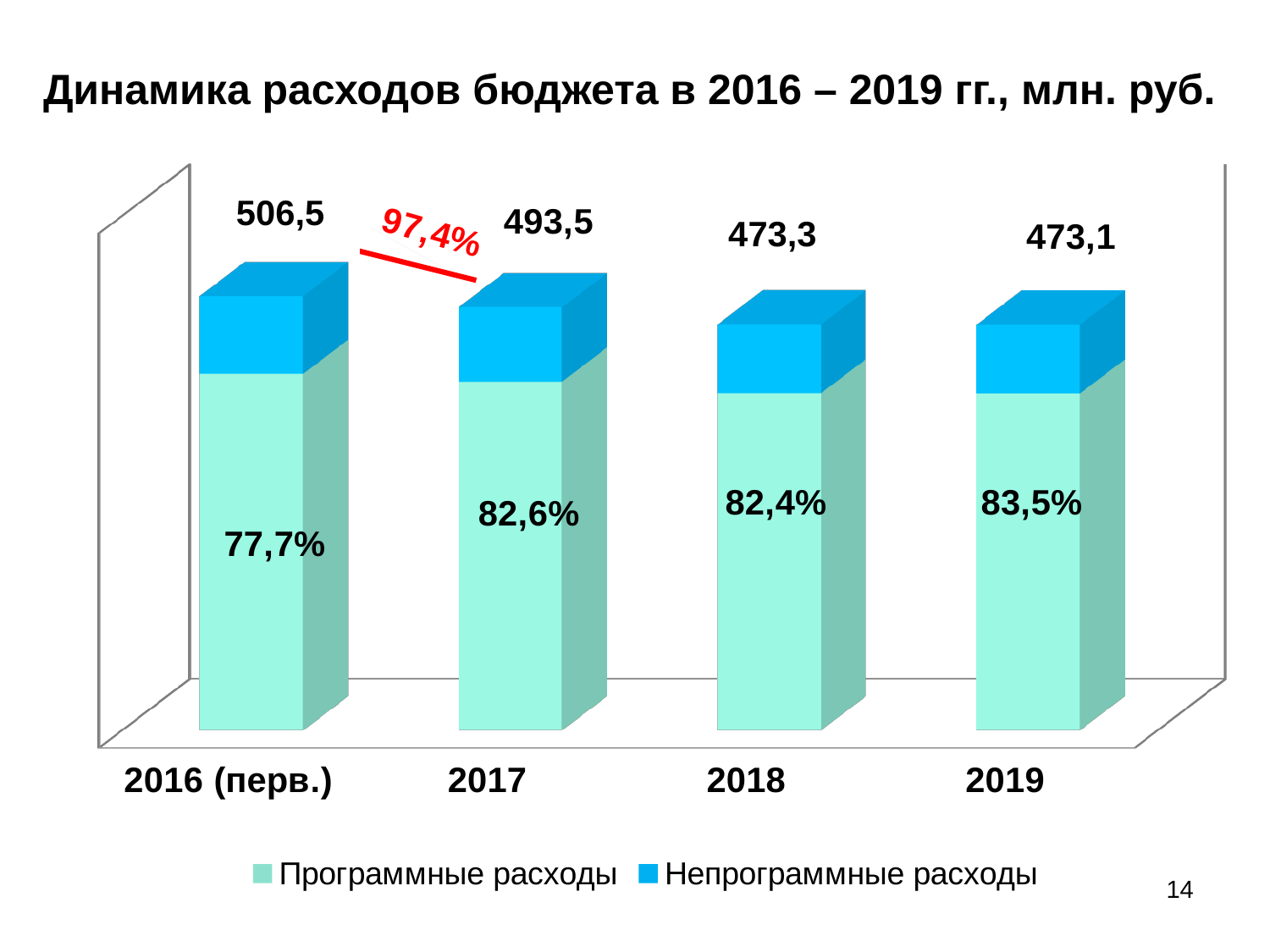
What is the difference between the total expenditure in 2016 (перв.) and in 2017? 13,0 How many series does the legend list? 2 What is the total budget expenditure shown for 2018? 473,3 Do the total expenditures rise or fall from 2016 (перв.) to 2019? Fall By how many percentage points is the Программные расходы share in 2019 higher than in 2016 (перв.)? 5,8% What kind of chart is shown on the slide? Stacked bar chart What share of expenditures is labelled as Программные расходы in 2019? 83,5% Which year has the highest total budget expenditure? 2016 (перв.) Which is larger, the total expenditure in 2017 or in 2018? 2017 What is the total budget expenditure shown for 2016 (перв.)? 506,5 How many years are shown on the x axis? 4 What share of expenditures is labelled as Программные расходы in 2016 (перв.)? 77,7%